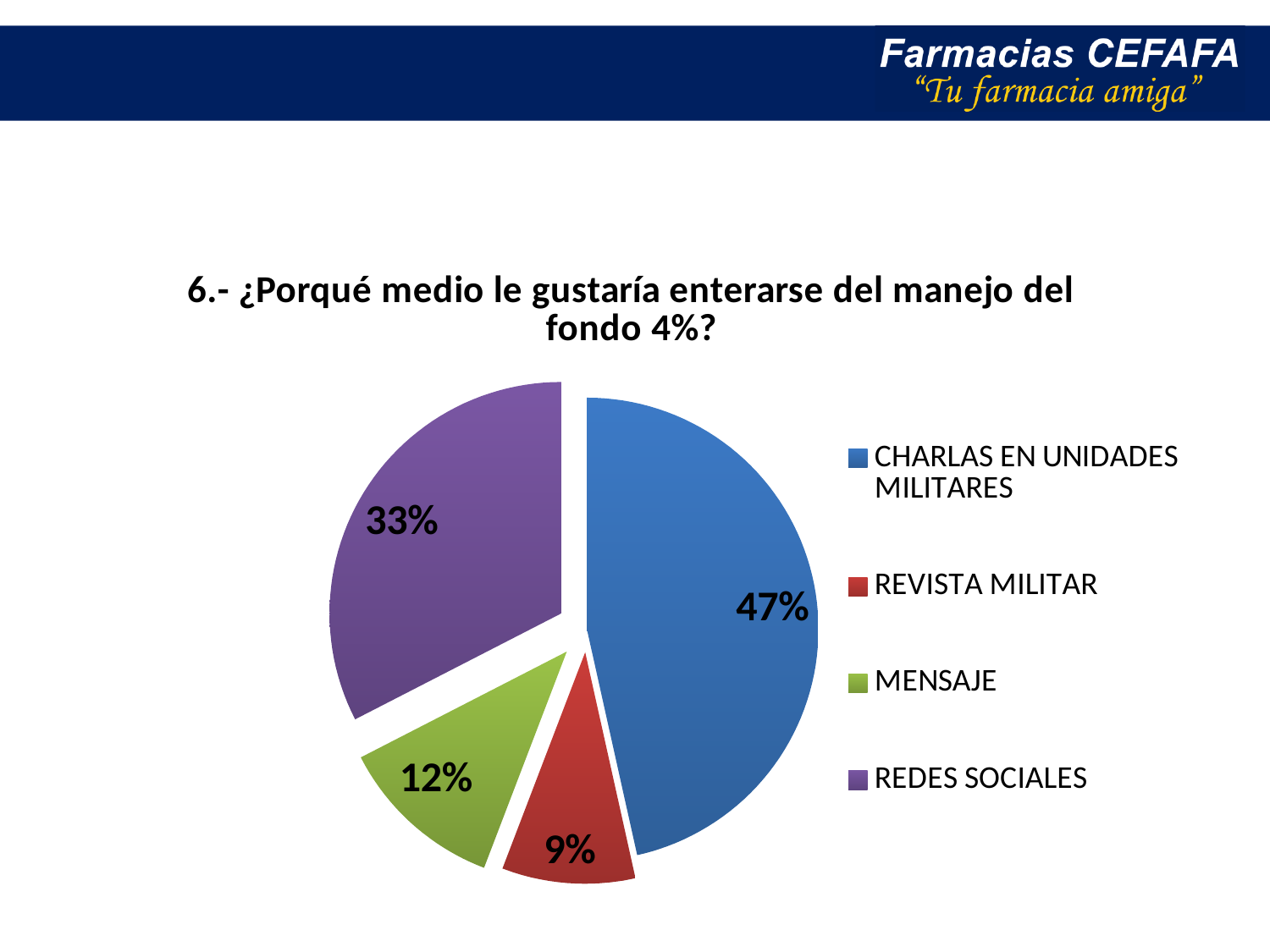
What is the value shown for REVISTA MILITAR? 9% What share of the pie does CHARLAS EN UNIDADES MILITARES represent? 47% What is the value shown for MENSAJE? 12% Which is larger, the slice for REDES SOCIALES or the slice for MENSAJE? REDES SOCIALES What is the difference in percentage points between CHARLAS EN UNIDADES MILITARES and REDES SOCIALES? 14 Which category has the largest slice of the pie? CHARLAS EN UNIDADES MILITARES What kind of chart is shown on the slide? Pie chart What share of the pie does REDES SOCIALES represent? 33% Which category has the smallest slice of the pie? REVISTA MILITAR How many categories does the pie chart show? 4 What is the difference in percentage points between MENSAJE and REVISTA MILITAR? 3 What colour is the slice for REDES SOCIALES? Purple